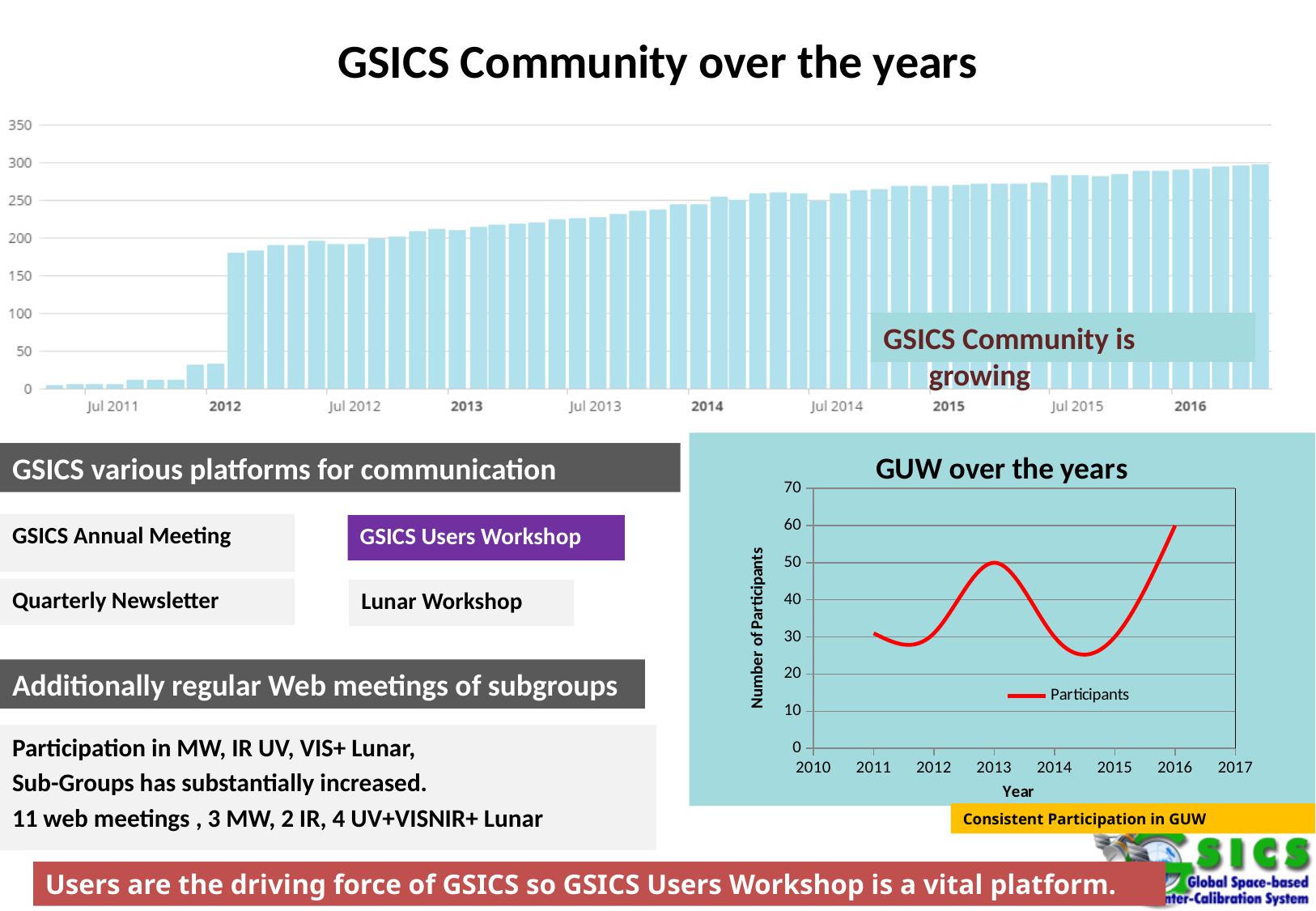
In the top chart 'GSICS Community over the years', is the value at 2012 greater or less than 150? greater How many series does the legend of the 'GUW over the years' chart list? 1 In the 'GUW over the years' chart, what is the number of participants in 2013? 50 What is the label of the y axis in the 'GUW over the years' chart? Number of Participants In the top chart 'GSICS Community over the years', is the value at Jul 2011 greater or less than 50? less In the 'GUW over the years' chart, which year has the highest number of participants? 2016 In the 'GUW over the years' chart, which is larger, the value for 2013 or the value for 2014? 2013 In the top chart 'GSICS Community over the years', is the value at 2016 greater or less than 250? greater What kind of chart is the 'GUW over the years' chart? line chart What kind of chart is the top chart titled 'GSICS Community over the years'? bar chart In the top chart 'GSICS Community over the years', do the values generally rise or fall from left to right? rise In the 'GUW over the years' chart, what is the number of participants in 2016? 60